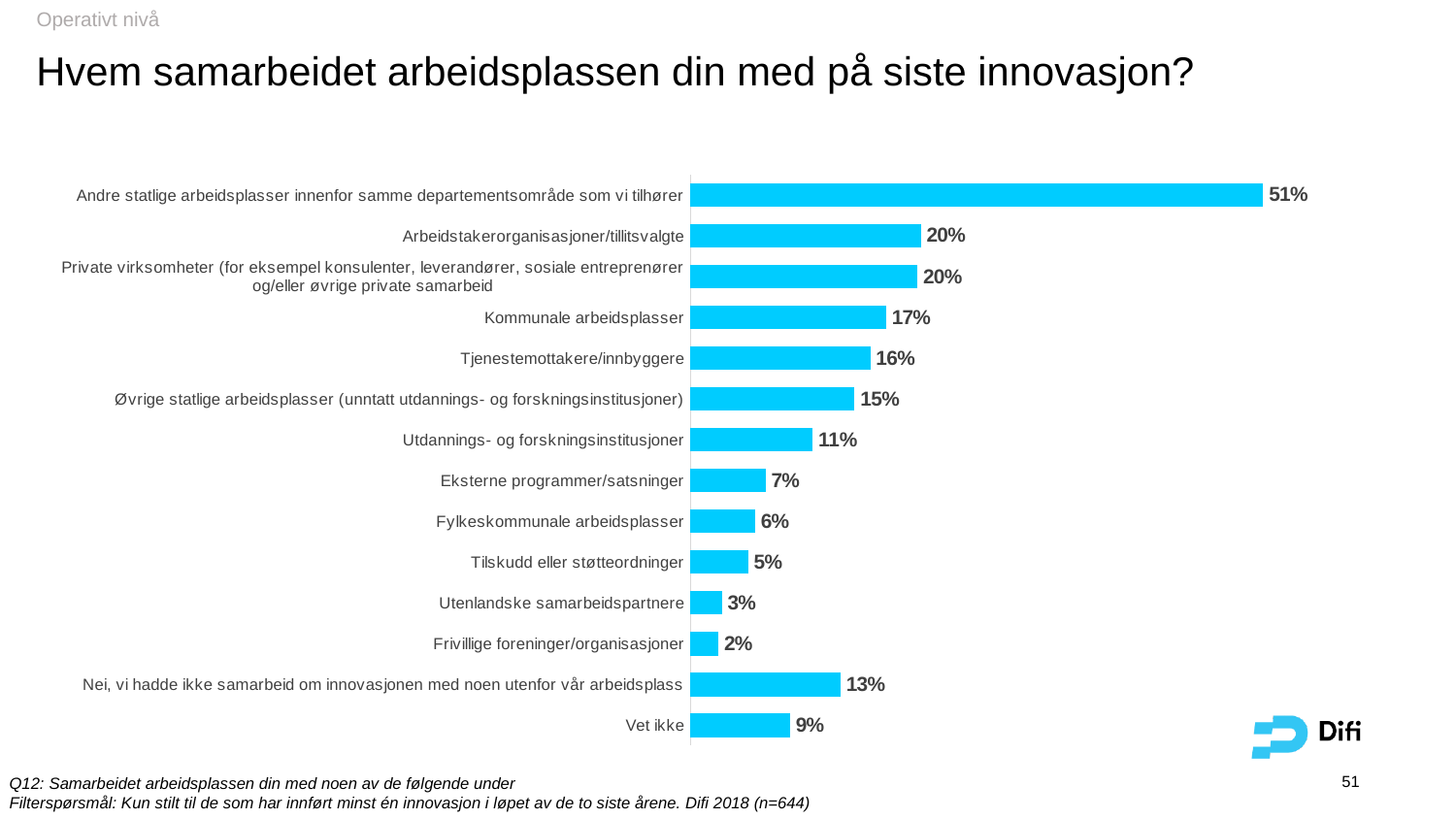
Which category has the highest value? Andre statlige arbeidsplasser innenfor samme departementsområde som vi tilhører Which is larger: the value for Fylkeskommunale arbeidsplasser or the value for Tilskudd eller støtteordninger? Fylkeskommunale arbeidsplasser What is the value for Kommunale arbeidsplasser? 17% What kind of chart is shown on the slide? Bar chart What is the value for Utenlandske samarbeidspartnere? 3% What is the difference between the value for Andre statlige arbeidsplasser innenfor samme departementsområde som vi tilhører and the value for Arbeidstakerorganisasjoner/tillitsvalgte? 31% Which category has the lowest value? Frivillige foreninger/organisasjoner Which is larger: the value for Eksterne programmer/satsninger or the value for Nei, vi hadde ikke samarbeid om innovasjonen med noen utenfor vår arbeidsplass? Nei, vi hadde ikke samarbeid om innovasjonen med noen utenfor vår arbeidsplass What is the value for Vet ikke? 9% What is the difference between the value for Tjenestemottakere/innbyggere and the value for Utdannings- og forskningsinstitusjoner? 5% How many categories are shown in the chart? 14 What is the title of the slide? Hvem samarbeidet arbeidsplassen din med på siste innovasjon?